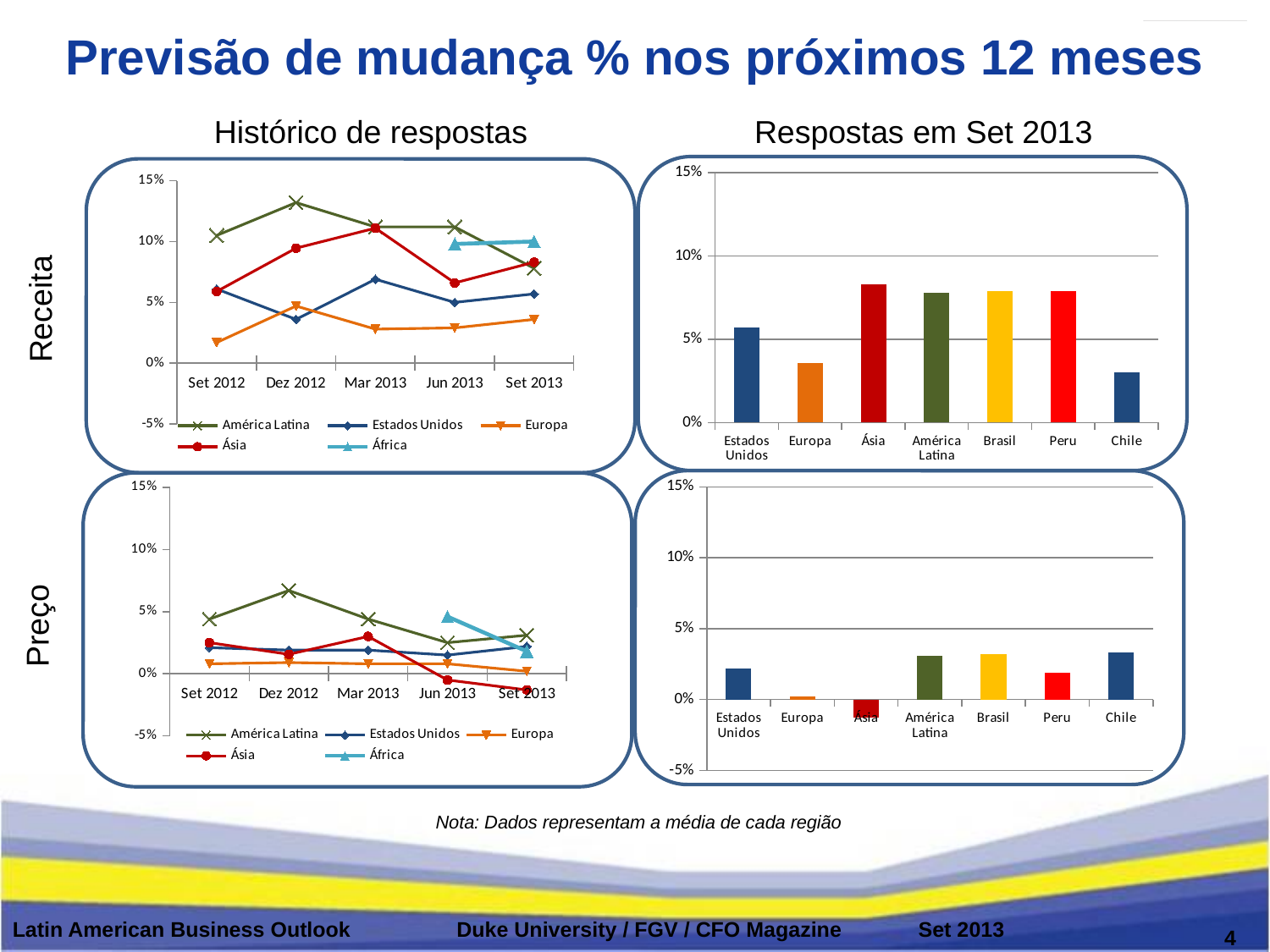
How many categories are shown on the x axis of the top-right bar chart (Receita, Set 2013)? 7 How many series does the legend of the top-left line chart (Receita, Histórico de respostas) list? 5 What kind of chart is the top-left chart (Receita, Histórico de respostas)? line chart In the top-right bar chart (Receita, Set 2013), is the value for Europa greater or less than 5%? less In the bottom-right bar chart (Preço, Set 2013), is the value for Ásia greater or less than 0%? less In the top-right bar chart (Receita, Set 2013), which category has the highest value? Ásia In the top-right bar chart (Receita, Set 2013), which is larger, the value for Ásia or the value for Chile? Ásia In the top-right bar chart (Receita, Set 2013), is the value for Estados Unidos greater or less than 5%? greater What kind of chart is the top-right chart (Receita, Respostas em Set 2013)? bar chart How many time points are shown on the x axis of the bottom-left line chart (Preço, Histórico de respostas)? 5 In the bottom-right bar chart (Preço, Set 2013), which category has the lowest value? Ásia In the bottom-left line chart (Preço, Histórico de respostas), does the Ásia series rise or fall from Mar 2013 to Set 2013? fall